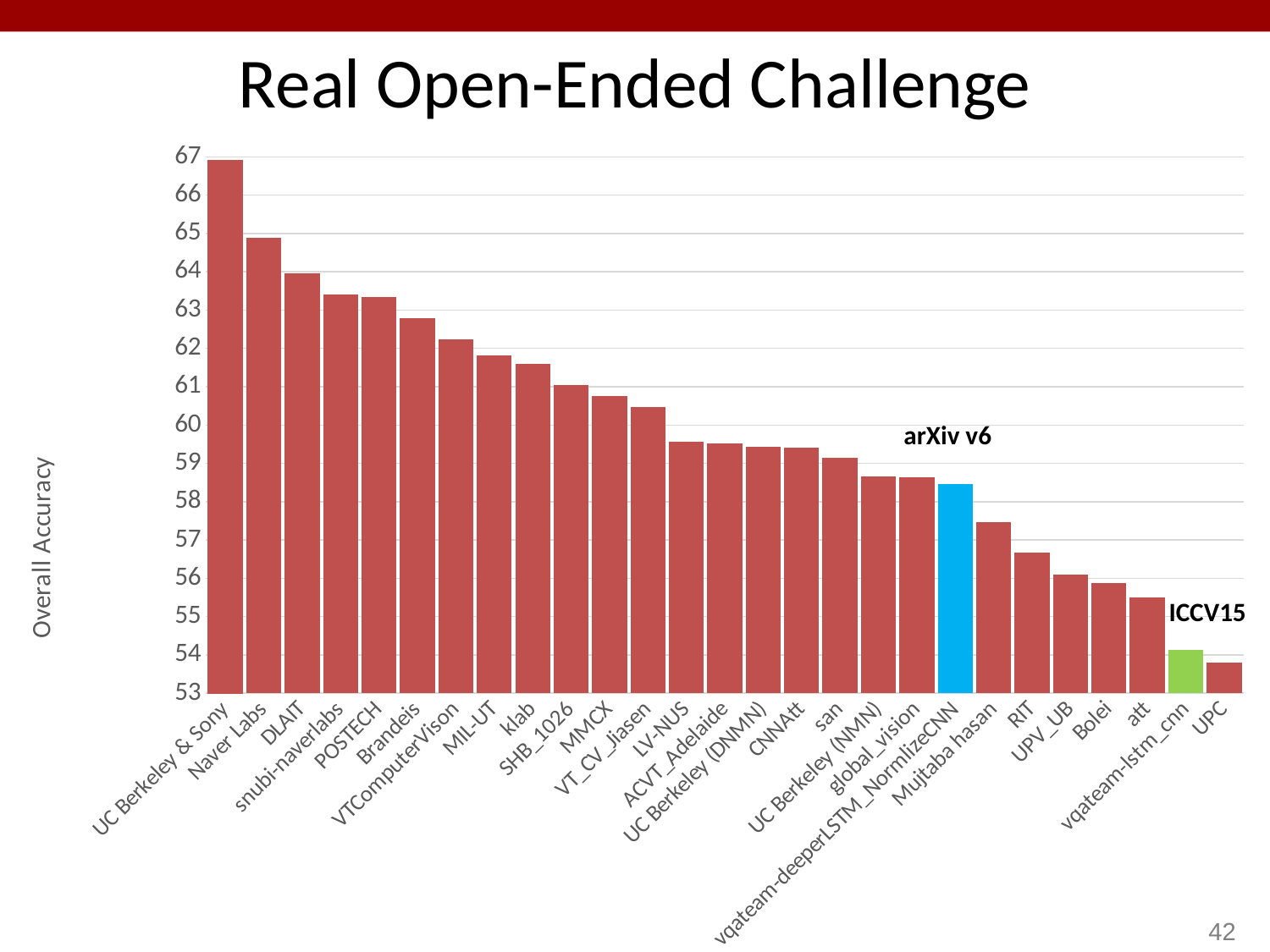
How many teams (bars) are shown in the chart? 27 Which team's bar is highlighted in blue and labelled "arXiv v6"? vqateam-deeperLSTM_NormlizeCNN Which team has the lowest overall accuracy? UPC Which team has the highest overall accuracy? UC Berkeley & Sony Is the value for UC Berkeley & Sony greater or less than 66? greater Is the value for Mujtaba hasan greater or less than 57? greater Is the value for MMCX greater or less than 60? greater What kind of chart is shown on the slide? bar chart What is the label of the y axis? Overall Accuracy Do the values rise or fall moving from left to right along the x axis? fall